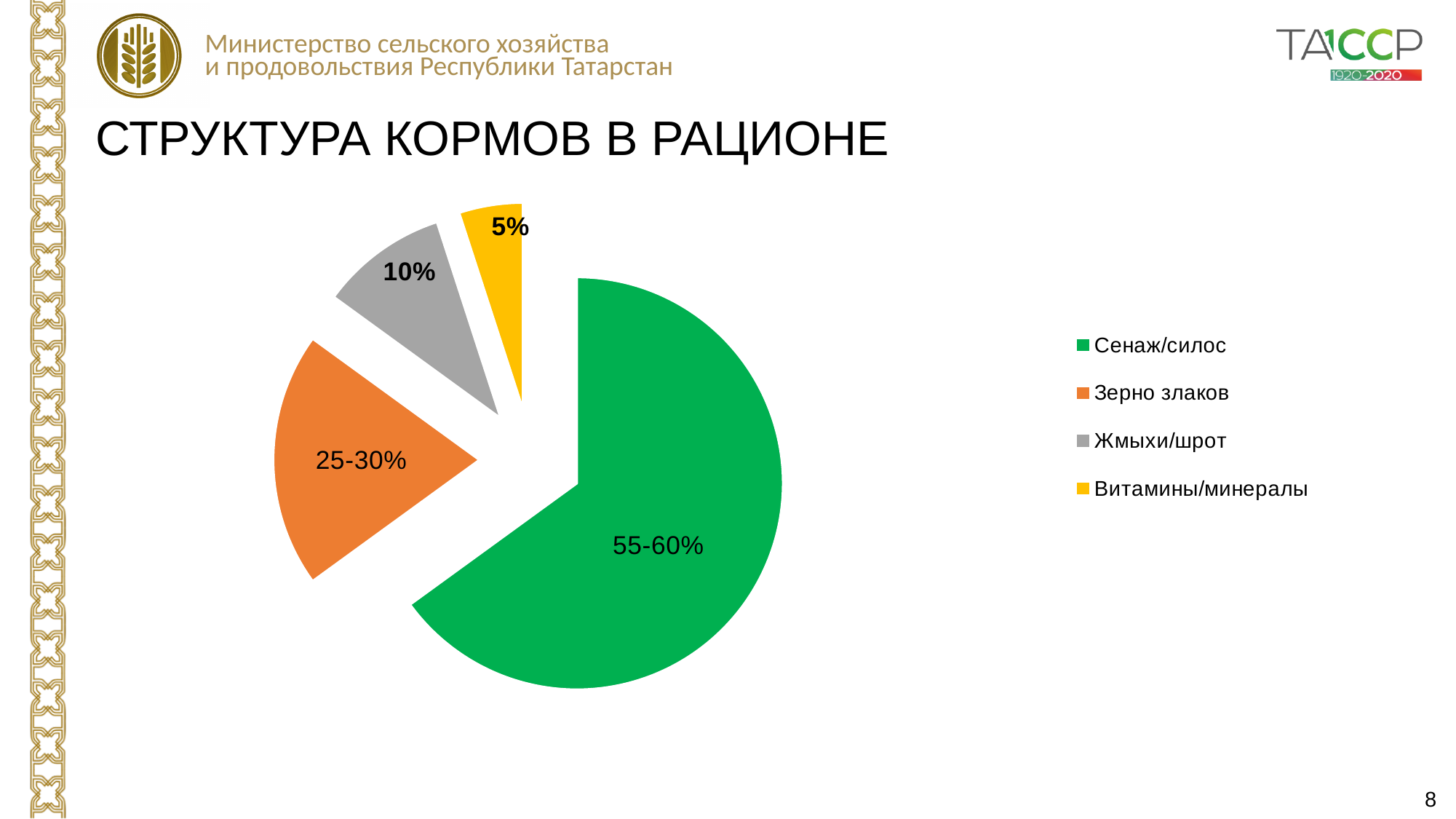
What percentage is labelled for Жмыхи/шрот? 10% What share is shown for Зерно злаков? 25-30% Which category has the smallest slice of the pie? Витамины/минералы By how many percentage points does Жмыхи/шрот exceed Витамины/минералы? 5% How many entries does the legend list? 4 What percentage is labelled for Витамины/минералы? 5% What colour is the slice for Зерно злаков? Orange What share of the ration does Сенаж/силос account for? 55-60% Which category has the largest slice of the pie? Сенаж/силос How many slices does the pie chart have? 4 Which is larger, the slice for Жмыхи/шрот or the slice for Витамины/минералы? Жмыхи/шрот What type of chart is shown on the slide? Pie chart